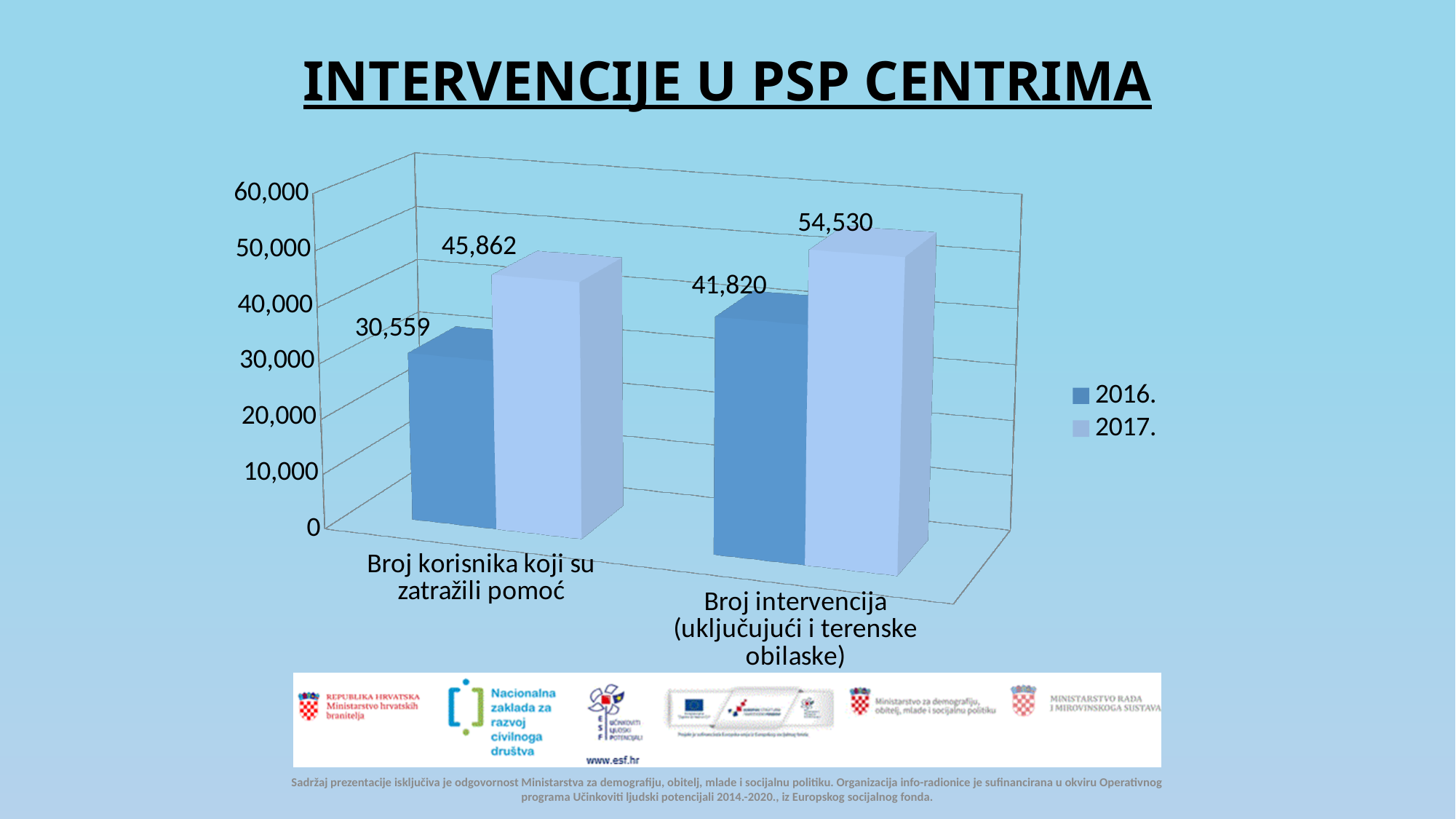
What is the difference between the 2017. and 2016. values for "Broj intervencija (uključujući i terenske obilaske)"? 12,710 What is the value for 2017. in the category "Broj korisnika koji su zatražili pomoć"? 45,862 Which is larger: the 2016. value for "Broj intervencija" or the 2017. value for "Broj korisnika koji su zatražili pomoć"? 2017. value for Broj korisnika koji su zatražili pomoć What kind of chart is shown on the slide? Bar chart How many series does the legend list? 2 How many categories are shown on the x axis? 2 Which bar has the lowest value on the chart? 2016. for Broj korisnika koji su zatražili pomoć What is the value for 2016. in the category "Broj korisnika koji su zatražili pomoć"? 30,559 What is the difference between the 2017. and 2016. values for "Broj korisnika koji su zatražili pomoć"? 15,303 What is the value for 2016. in the category "Broj intervencija (uključujući i terenske obilaske)"? 41,820 What is the value for 2017. in the category "Broj intervencija (uključujući i terenske obilaske)"? 54,530 Which bar has the highest value on the chart? 2017. for Broj intervencija (uključujući i terenske obilaske)